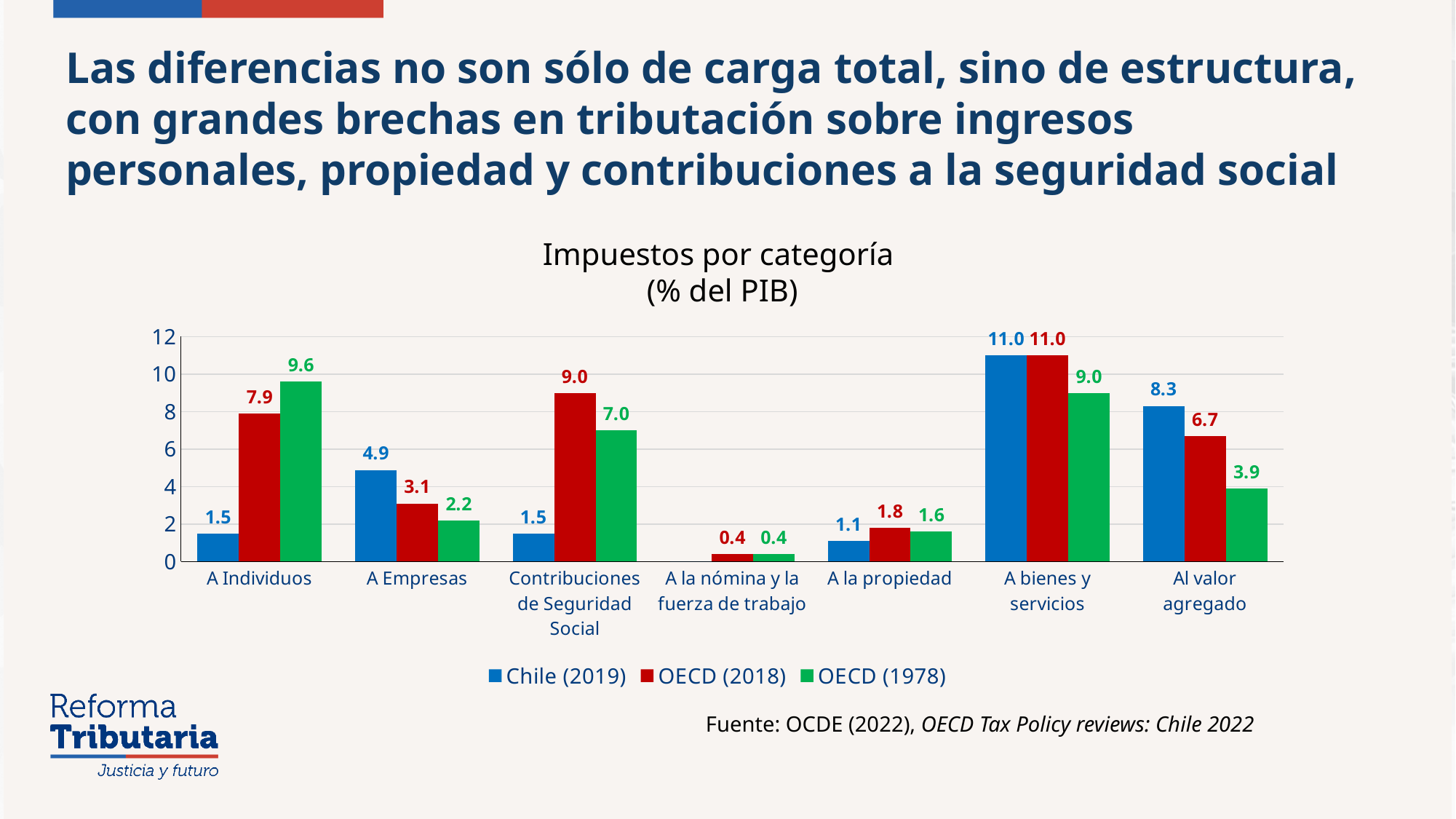
What is the value for OECD (2018) in the 'Al valor agregado' category? 6.7 What kind of chart is shown on the slide? Bar chart What is the difference between the OECD (2018) and Chile (2019) values for 'A Individuos'? 6.4 Which category has the lowest value for OECD (2018)? A la nómina y la fuerza de trabajo What is the value for OECD (1978) in the 'Contribuciones de Seguridad Social' category? 7.0 Which is larger for 'A Empresas': Chile (2019) or OECD (2018)? Chile (2019) What is the title of the chart? Impuestos por categoría (% del PIB) How many series does the legend list? 3 What is the value for Chile (2019) in the 'A Individuos' category? 1.5 Which category has the highest value for Chile (2019)? A bienes y servicios How many categories are shown on the x axis? 7 What is the difference between the Chile (2019) and OECD (1978) values for 'Al valor agregado'? 4.4